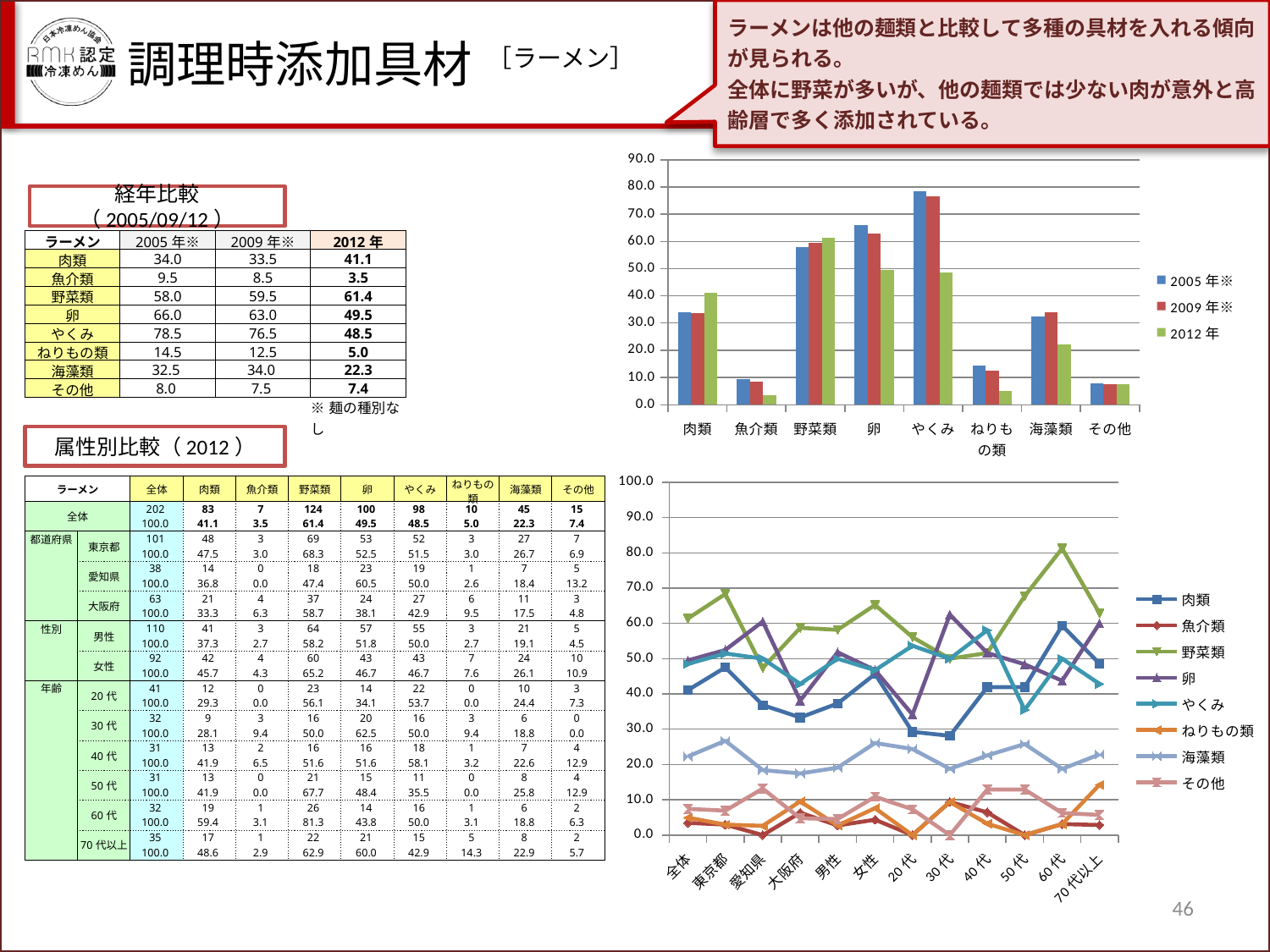
In the bottom-right line chart, is the 海藻類 value for 全体 greater or less than 30? less In the top-right bar chart, which category has the lowest value for the 2012年 series? 魚介類 In the top-right bar chart, is the 2009年※ value for やくみ greater or less than 70? greater How many series does the legend of the bottom-right line chart list? 8 What kind of chart is the top-right chart on the slide? bar chart How many series does the legend of the top-right bar chart list? 3 What kind of chart is the bottom-right chart on the slide? line chart In the top-right bar chart, which category has the highest value for the 2005年※ series? やくみ How many categories are shown on the x axis of the top-right bar chart? 8 How many categories are shown on the x axis of the bottom-right line chart? 12 In the top-right bar chart, what is the 2012年 value for 肉類? 41.1 In the top-right bar chart, what is the difference between the 2005年※ and 2012年 values for 卵? 16.5